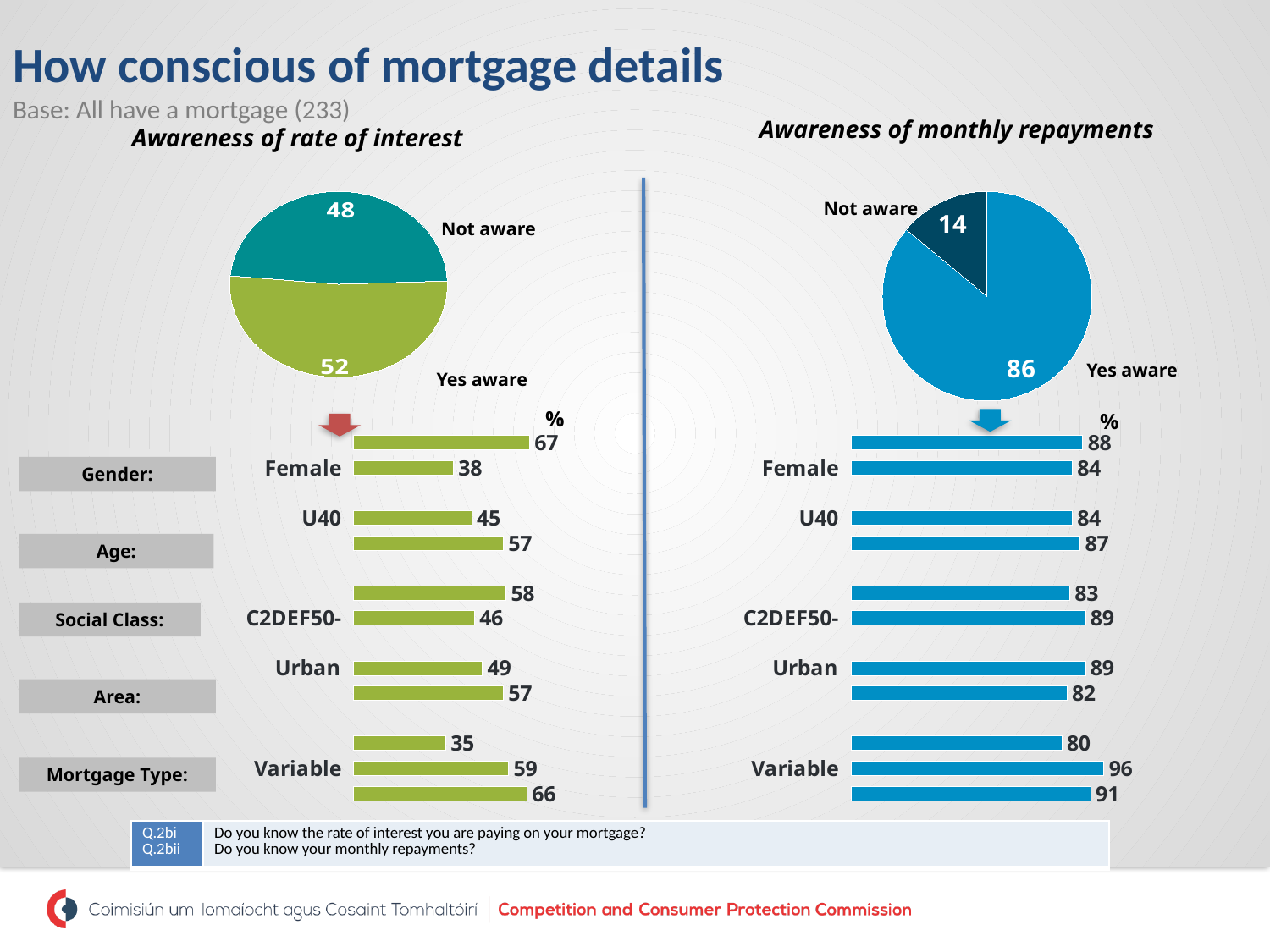
In the 'Awareness of monthly repayments' bar chart, what is the value for C2DEF50-? 89 In the 'Awareness of rate of interest' pie chart, what percentage is 'Not aware'? 48 What is the difference between the Female value in the 'Awareness of monthly repayments' bar chart and the Female value in the 'Awareness of rate of interest' bar chart? 46 How many slices does the 'Awareness of monthly repayments' pie chart have? 2 In the 'Awareness of monthly repayments' bar chart, which bar has the highest value? Variable In the 'Awareness of rate of interest' bar chart, which is lower, the value for Female or the value for C2DEF50-? Female In the 'Awareness of monthly repayments' pie chart, what value is shown for 'Yes aware'? 86 In the 'Awareness of rate of interest' bar chart, which is larger, the value for Urban or the value for U40? Urban What kind of chart is used at the top of the 'Awareness of rate of interest' section? Pie chart What is the difference between the Variable value in the 'Awareness of monthly repayments' bar chart and the Variable value in the 'Awareness of rate of interest' bar chart? 37 In the 'Awareness of monthly repayments' bar chart, what is the value for Variable? 96 In the 'Awareness of rate of interest' bar chart, what is the value for Female? 38